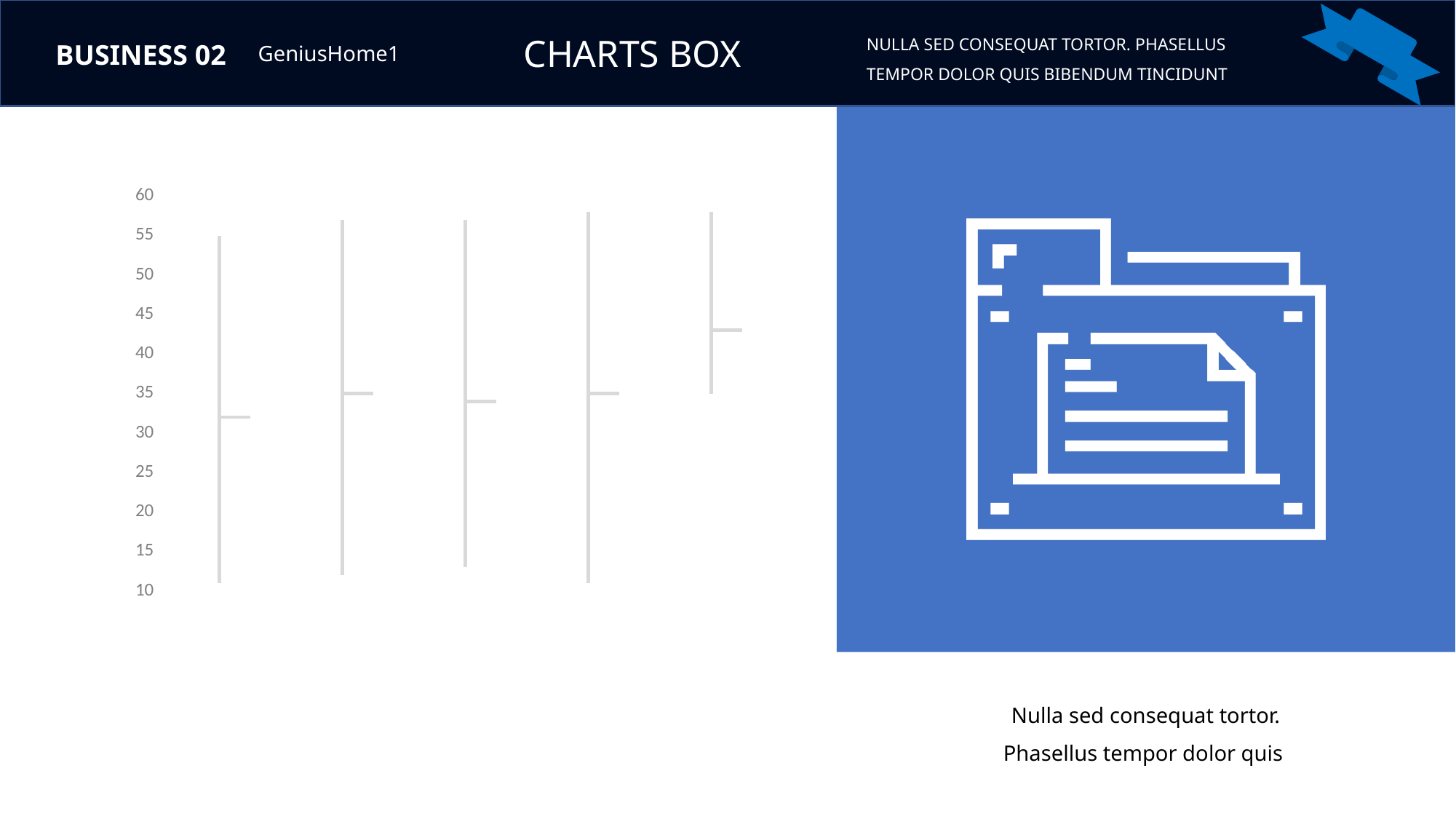
Is the bottom of the leftmost line greater or less than 15? less Is the bottom of the rightmost line greater or less than 30? greater What is the highest value labelled on the vertical axis of the chart? 60 Is the horizontal marker on the rightmost line greater or less than 40? greater What is the lowest value labelled on the vertical axis of the chart? 10 How many vertical high-low lines are plotted on the chart? 5 What kind of chart is shown on the slide? stock (high-low) chart